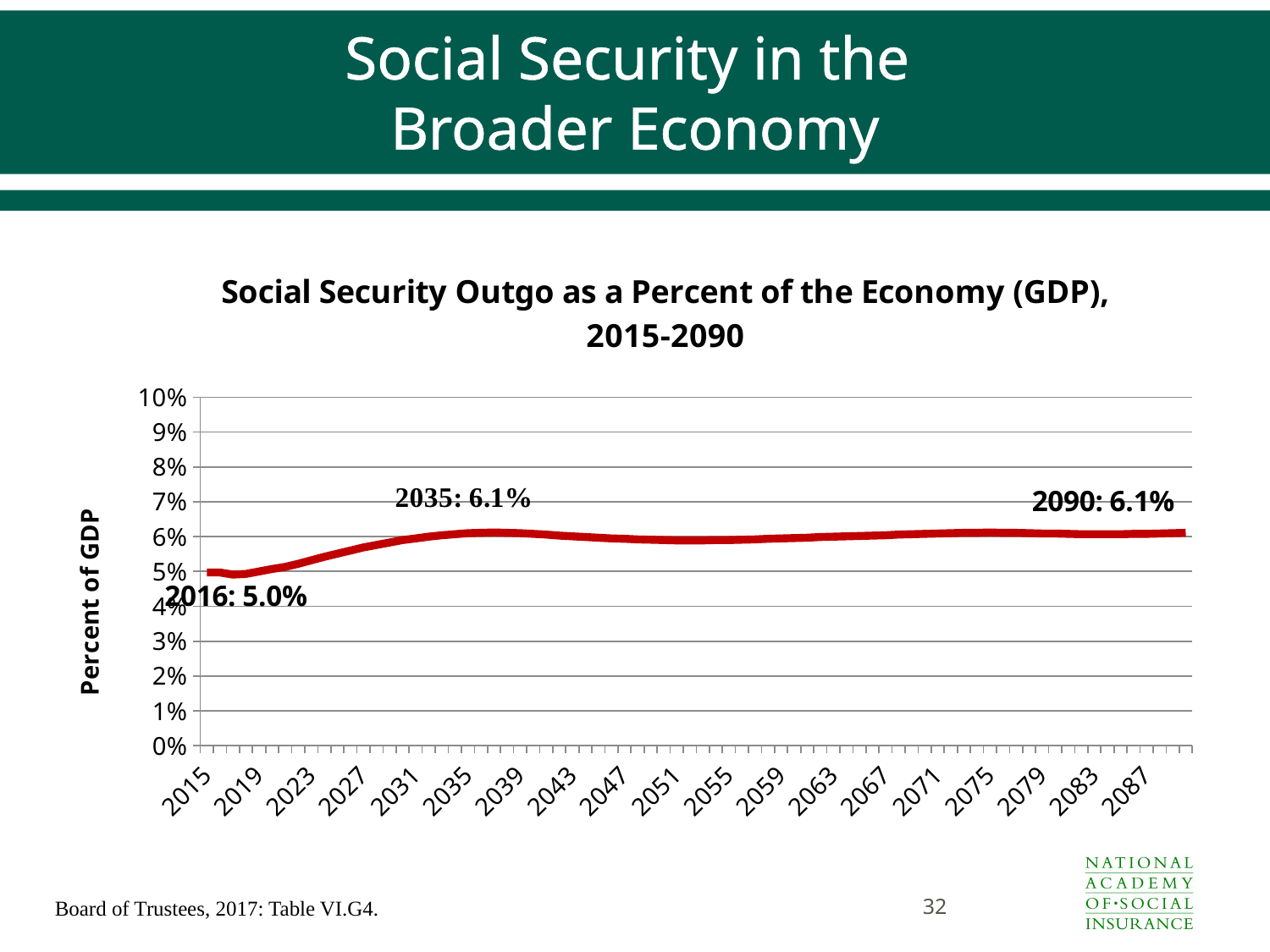
Is the value for 2015 greater or less than 6%? less What value is labeled on the chart for 2035? 6.1% What kind of chart is shown on the slide? Line chart What is the title of the vertical axis? Percent of GDP Does the line rise or fall between 2015 and 2035? Rises Is the value for 2071 greater or less than 7%? less Which year has the larger labeled value, 2016 or 2035? 2035 What is the Social Security outgo as a percent of GDP in 2016, as labeled on the chart? 5.0% By how many percentage points does the labeled value for 2035 exceed the labeled value for 2016? 1.1 percentage points What value is labeled on the chart for 2090? 6.1% How many lines are plotted on the chart? 1 Is the value for 2051 greater or less than 5%? greater